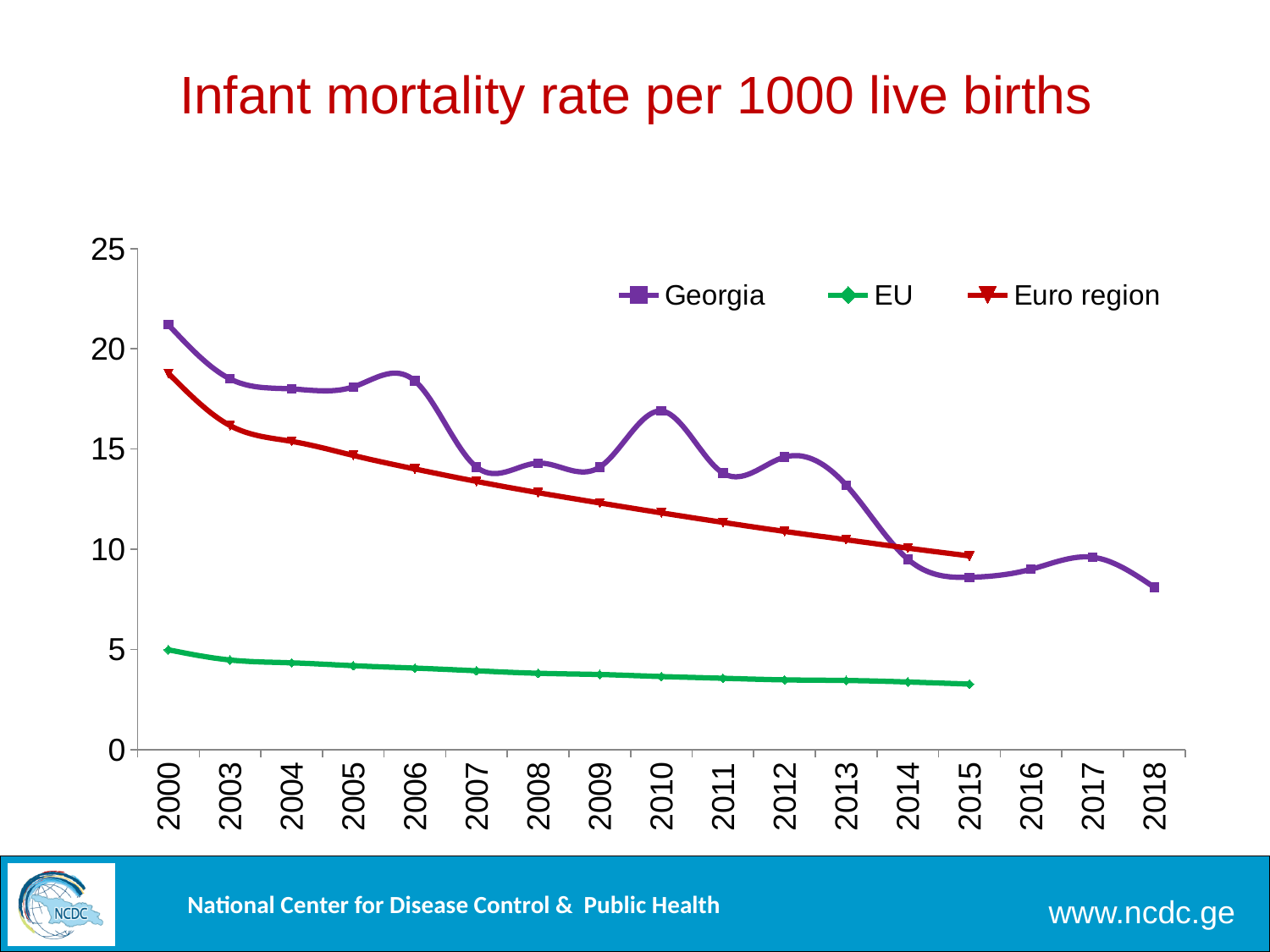
What is the title of the chart? Infant mortality rate per 1000 live births Does the Euro region series rise or fall from 2000 to 2015? fall How many years are shown on the x axis? 17 How many series does the legend list? 3 What kind of chart is shown on the slide? line chart Which series is drawn in green? EU In 2010, which is larger, the Georgia value or the Euro region value? Georgia In which year is the Georgia value highest? 2000 Does the EU series rise or fall from 2000 to 2015? fall Is the value for Georgia in 2000 greater or less than 20? greater In which year is the Georgia value lowest? 2018